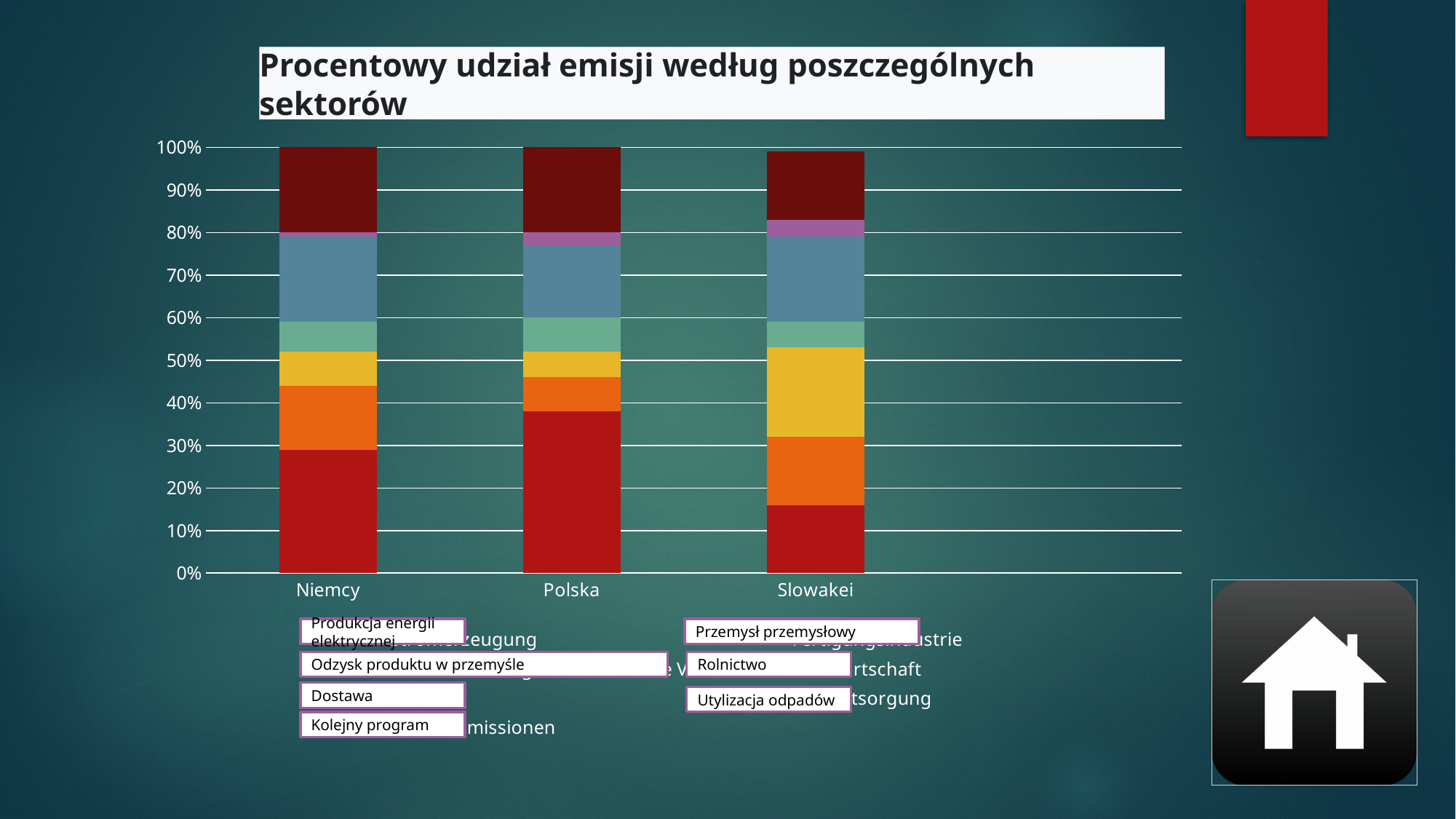
How many countries (categories) are shown on the x axis of the chart? 3 Which countries are shown on the x axis of the chart? Niemcy, Polska, Slowakei How many series does the legend of the chart list? 7 What is the highest value shown on the y axis of the chart? 100% Which country has the larger bottom (dark red) segment, Niemcy or Polska? Polska Which country has the larger yellow segment, Niemcy or Slowakei? Slowakei Is the bottom (dark red) segment of the Slowakei bar greater or less than 20%? less Which country has the largest yellow segment in its bar? Slowakei What is the title of the chart? Procentowy udział emisji według poszczególnych sektorów Is the bottom (dark red) segment of the Polska bar greater or less than 30%? greater What type of chart is shown on the slide? Stacked bar chart Which country has the smallest bottom (dark red) segment in its bar? Slowakei